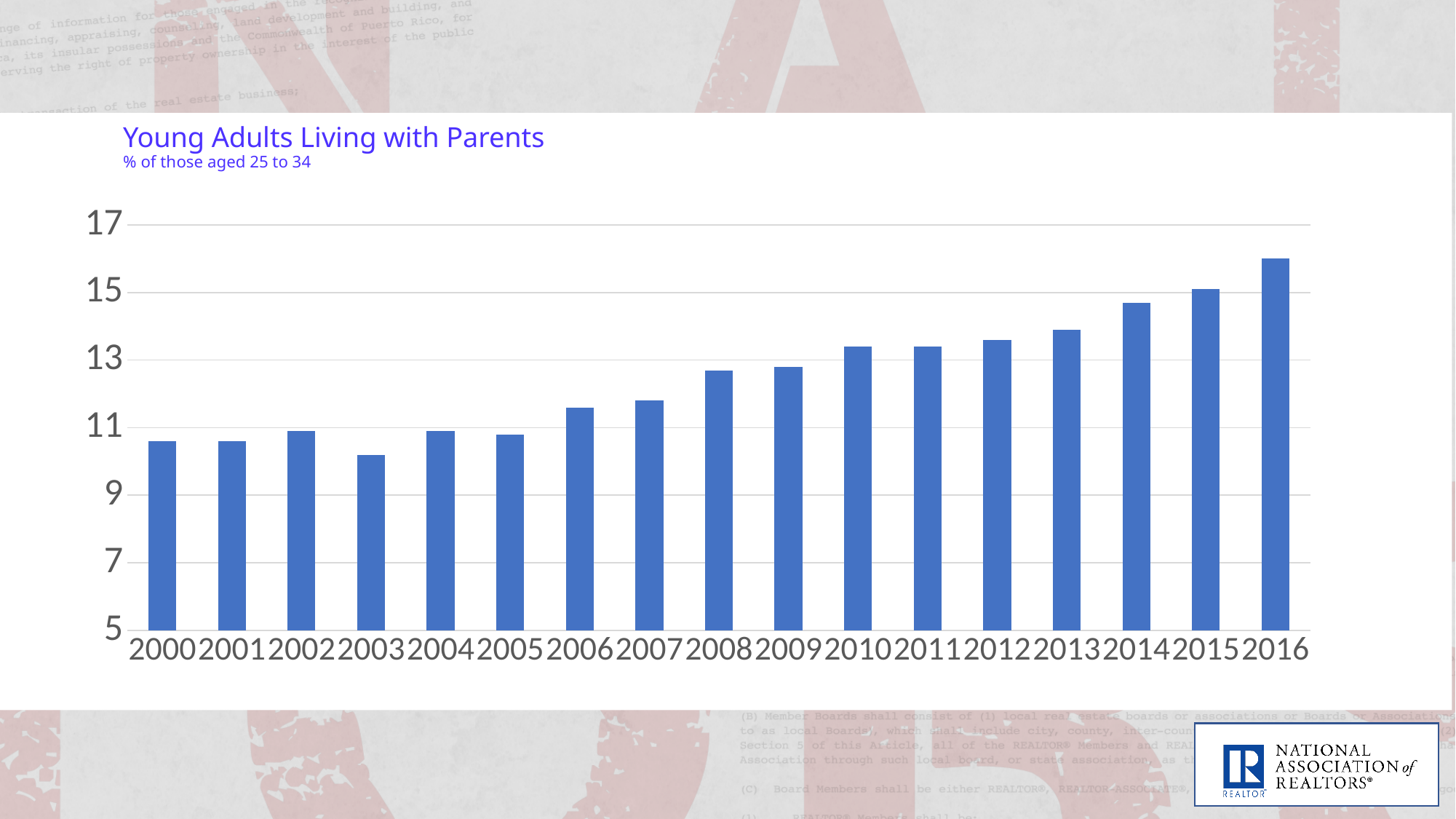
What kind of chart is shown on the slide? bar chart Which year has the larger value, 2000 or 2016? 2016 What is the title of the chart? Young Adults Living with Parents Is the value for 2014 greater or less than 15? less How many years are shown on the x axis of the chart? 17 Is the value for 2003 greater or less than 11? less Do the values generally rise or fall from 2000 to 2016? rise Is the value for 2016 greater or less than 15? greater What does the subtitle under the chart title say the values represent? % of those aged 25 to 34 Which year has the lowest value in the chart? 2003 Which year has the highest value in the chart? 2016